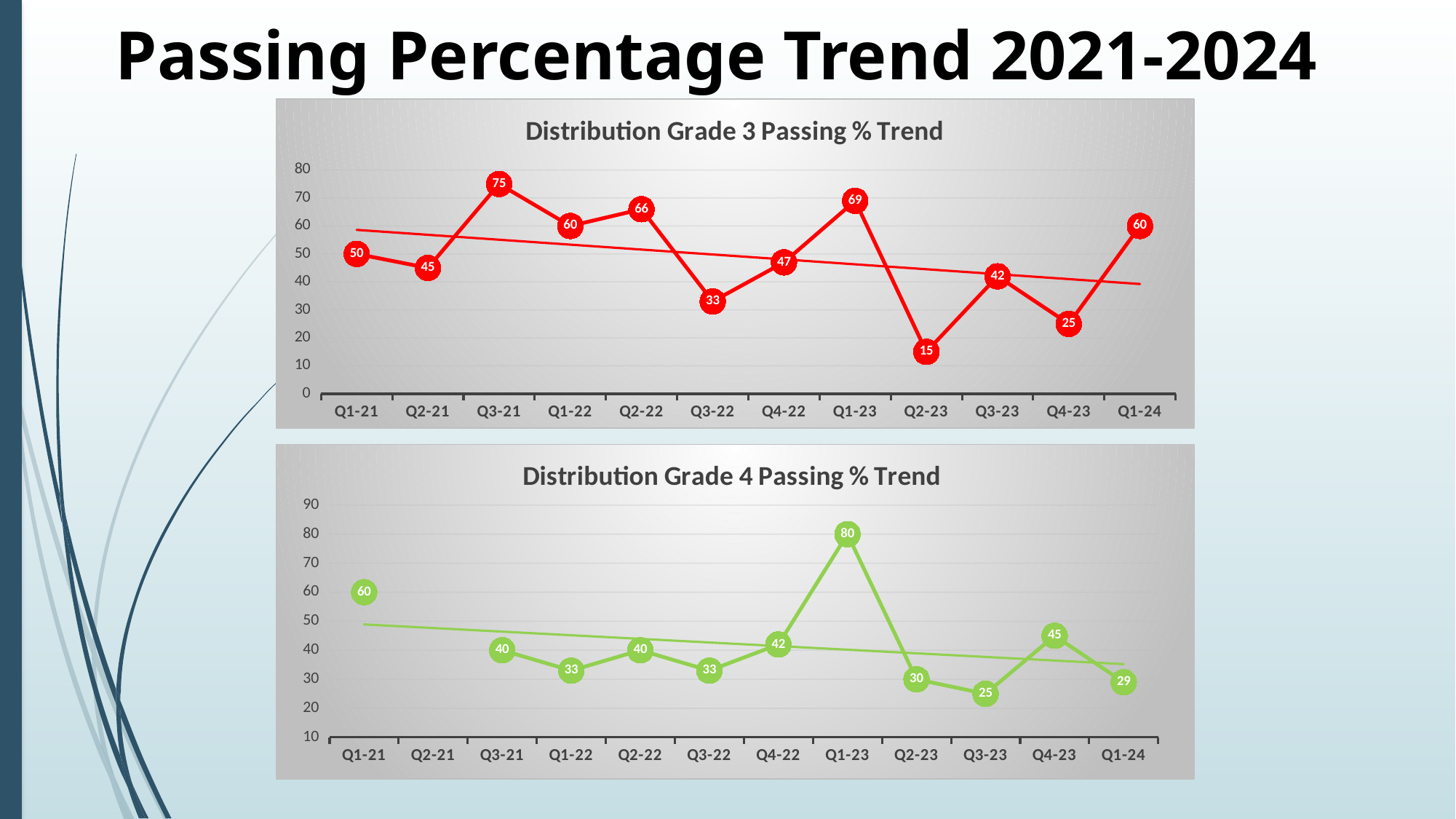
In the 'Distribution Grade 3 Passing % Trend' chart, what is the value for Q3-21? 75 In the 'Distribution Grade 3 Passing % Trend' chart, which quarter has the lowest value? Q2-23 In the 'Distribution Grade 4 Passing % Trend' chart, what is the difference between the values for Q1-21 and Q1-24? 31 In the 'Distribution Grade 4 Passing % Trend' chart, which quarter has the lowest value? Q3-23 What colour are the data markers in the 'Distribution Grade 4 Passing % Trend' chart? Green In the 'Distribution Grade 4 Passing % Trend' chart, what is the value for Q1-23? 80 In the 'Distribution Grade 3 Passing % Trend' chart, does the trendline rise or fall from left to right? Fall In the 'Distribution Grade 3 Passing % Trend' chart, how many quarters are plotted on the x axis? 12 In the 'Distribution Grade 3 Passing % Trend' chart, what is the difference between the values for Q1-23 and Q2-23? 54 What kind of chart is the 'Distribution Grade 4 Passing % Trend' chart? Line chart In the 'Distribution Grade 3 Passing % Trend' chart, which is larger, the value for Q2-22 or the value for Q4-22? Q2-22 In the 'Distribution Grade 4 Passing % Trend' chart, which is larger, the value for Q4-23 or the value for Q2-23? Q4-23